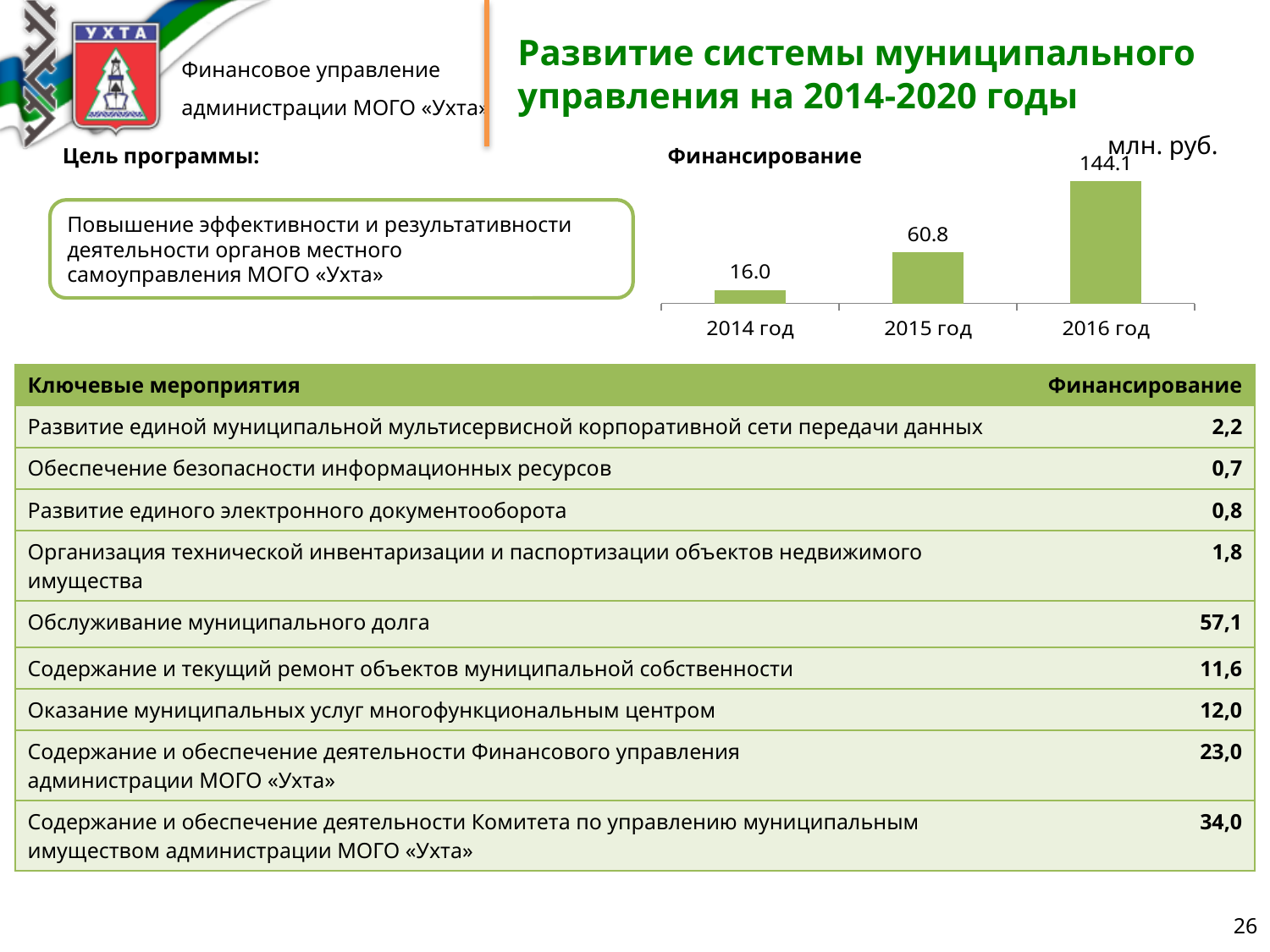
What kind of chart is the Финансирование chart? bar chart Do the values in the Финансирование chart rise or fall from 2014 год to 2016 год? rise What is the value for 2015 год in the Финансирование chart? 60.8 How many bars are shown in the Финансирование chart? 3 What is the value for 2016 год in the Финансирование chart? 144.1 What unit is indicated for the values in the Финансирование chart? млн. руб. Which is larger in the Финансирование chart, the value for 2014 год or 2015 год? 2015 год Which year has the lowest value in the Финансирование chart? 2014 год Which year has the highest value in the Финансирование chart? 2016 год What is the difference between the values for 2016 год and 2015 год in the Финансирование chart? 83.3 What is the value for 2014 год in the Финансирование chart? 16.0 What is the difference between the values for 2015 год and 2014 год in the Финансирование chart? 44.8